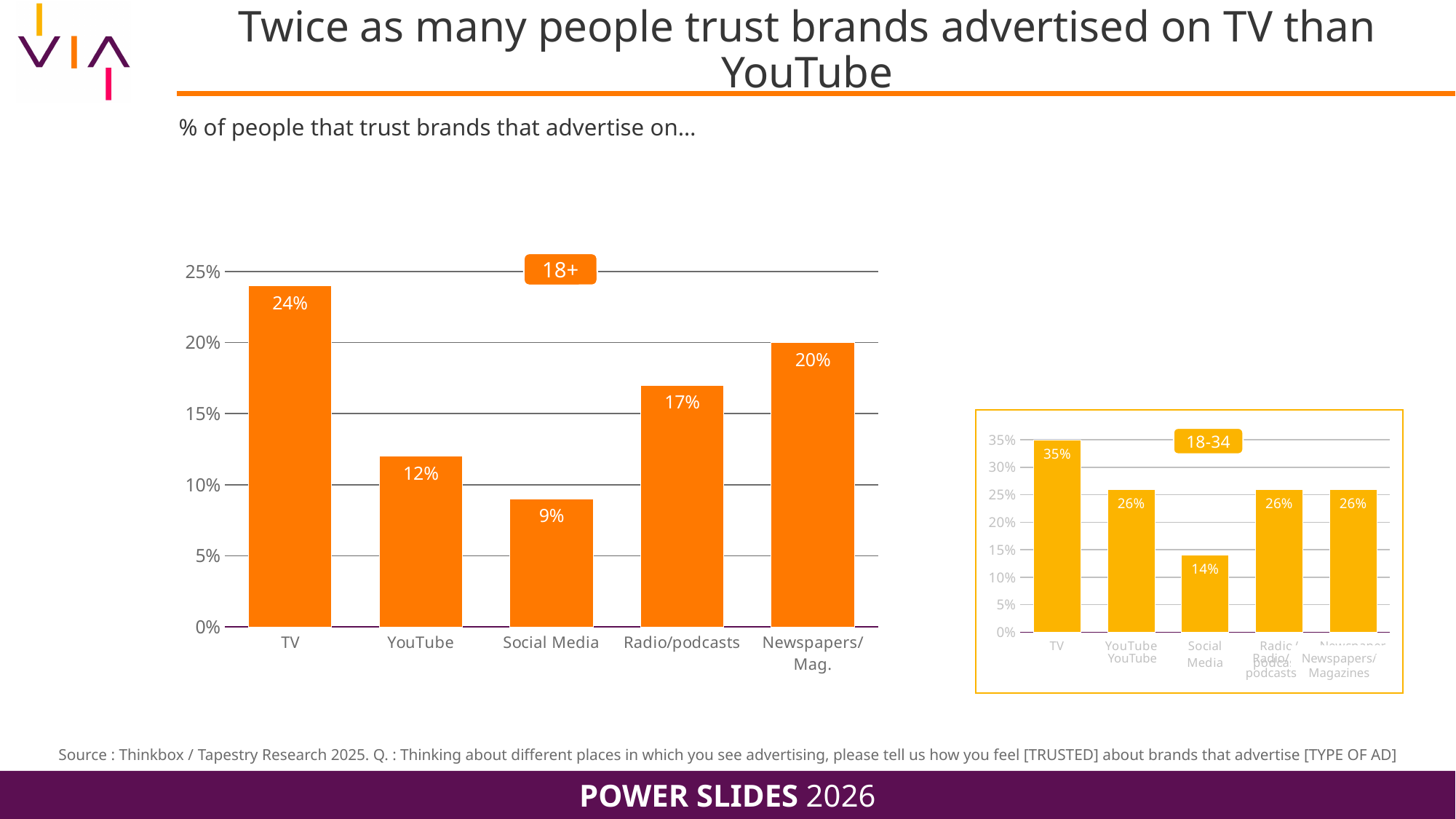
In the 18-34 chart on the right, what is the value for TV? 35% In the 18-34 chart on the right, what is the value for Social Media? 14% What type of chart is the 18+ chart on the left? Bar chart In the 18+ chart on the left, which category has the highest value? TV In the 18+ chart on the left, which is larger: Radio/podcasts or Newspapers/Mag.? Newspapers/Mag. In the 18+ chart on the left, what is the difference between the TV value and the YouTube value? 12% In the 18-34 chart on the right, which category has the lowest value? Social Media In the 18+ chart on the left, what percentage of people trust brands that advertise on TV? 24% How many categories are shown in the 18+ chart on the left? 5 In the 18-34 chart on the right, what is the difference between the TV value and the Social Media value? 21% In the 18+ chart on the left, which category has the lowest value? Social Media In the 18+ chart on the left, what is the value for Social Media? 9%